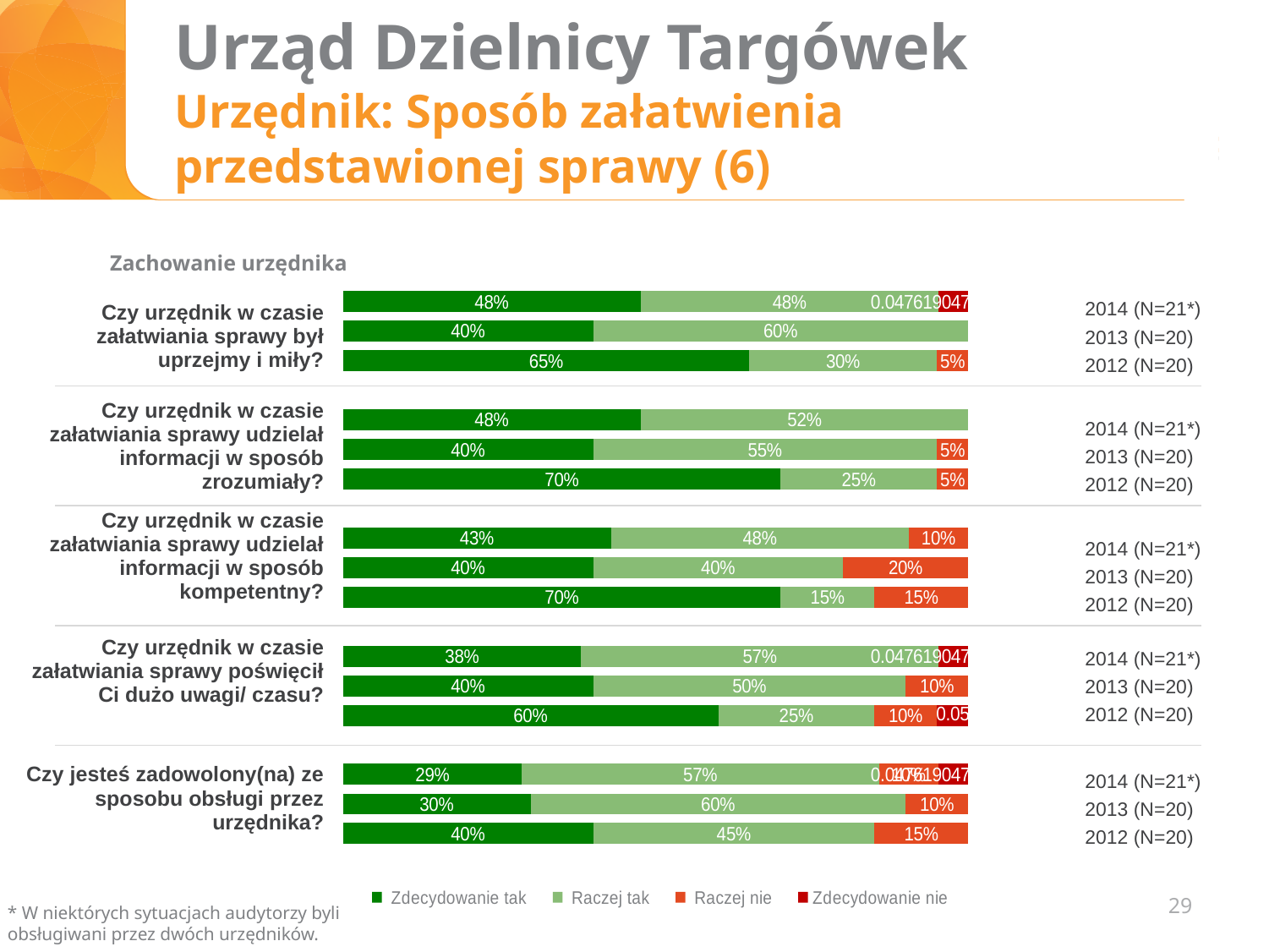
How many years (bars) are shown for each question? 3 In the chart for 'Czy urzędnik w czasie załatwiania sprawy udzielał informacji w sposób zrozumiały?', which year has the highest 'Zdecydowanie tak' share? 2012 (N=20) What kind of chart is used on this slide? Stacked bar chart In the chart for 'Czy jesteś zadowolony(na) ze sposobu obsługi przez urzędnika?', does the 'Zdecydowanie tak' share rise or fall from 2012 to 2014? Fall In the chart for 'Czy urzędnik w czasie załatwiania sprawy udzielał informacji w sposób zrozumiały?', what is the 'Raczej tak' value for 2013 (N=20)? 55% In the chart for 'Czy urzędnik w czasie załatwiania sprawy poświęcił Ci dużo uwagi/ czasu?', which year has the larger 'Raczej tak' share, 2013 or 2012? 2013 (N=20) In the chart for 'Czy urzędnik w czasie załatwiania sprawy był uprzejmy i miły?', what is the 'Zdecydowanie tak' value for 2012 (N=20)? 65% In the chart for 'Czy urzędnik w czasie załatwiania sprawy udzielał informacji w sposób kompetentny?', what is the total of the 2013 (N=20) bar? 100% In the chart for 'Czy urzędnik w czasie załatwiania sprawy udzielał informacji w sposób kompetentny?', what is the 'Raczej nie' value for 2013 (N=20)? 20% In the chart for 'Czy urzędnik w czasie załatwiania sprawy udzielał informacji w sposób kompetentny?', how much higher is the 'Zdecydowanie tak' share in 2012 than in 2014? 27 percentage points In the chart for 'Czy jesteś zadowolony(na) ze sposobu obsługi przez urzędnika?', which year has the lowest 'Zdecydowanie tak' share? 2014 (N=21*) How many series does the legend list? 4